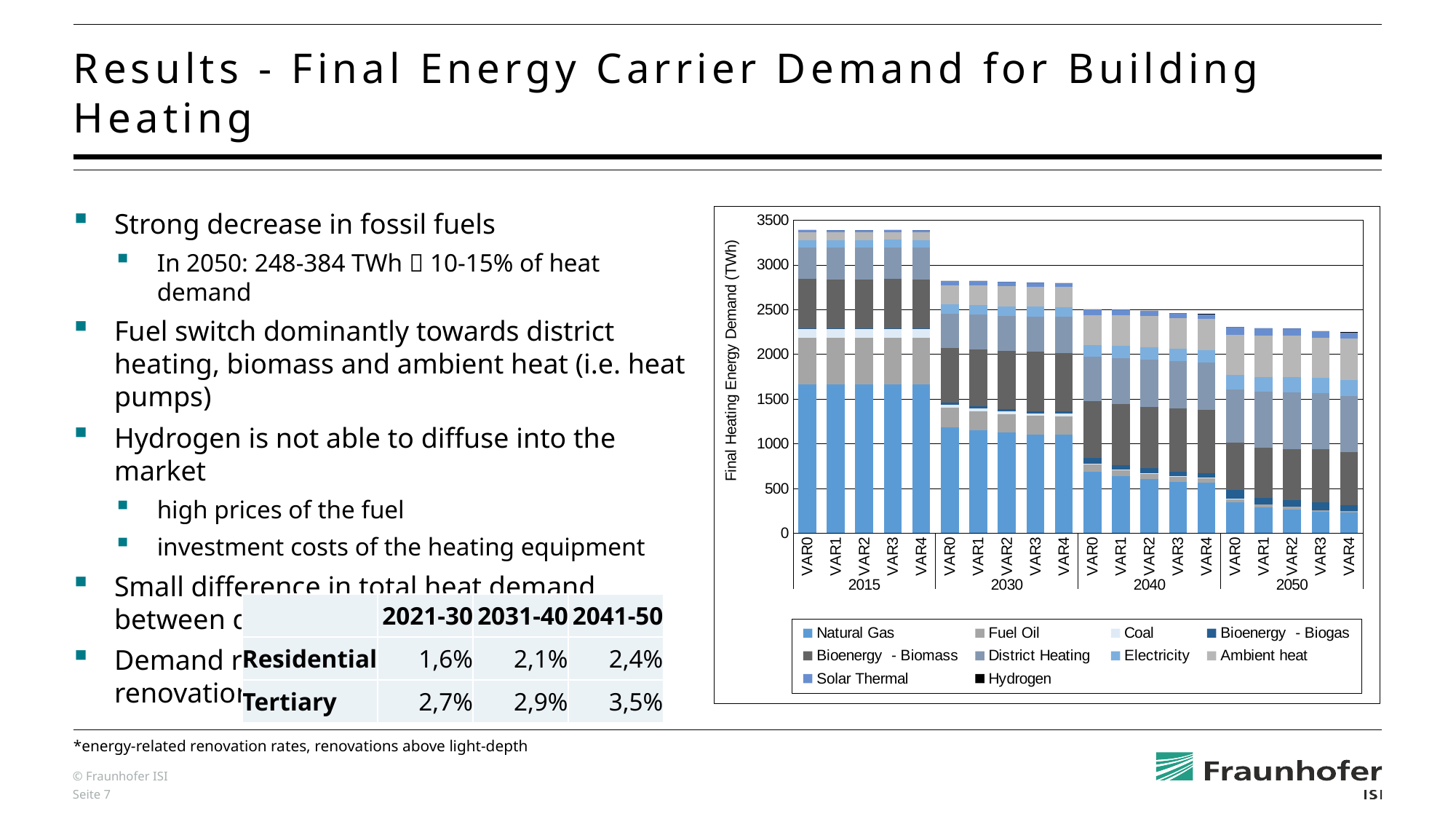
Is the Natural Gas value for VAR0 in 2015 greater or less than 1500? greater How many series does the chart legend list? 10 Which is larger, the total bar for VAR0 in 2015 or the total bar for VAR0 in 2050? VAR0 in 2015 What kind of chart is shown on the slide? Stacked bar chart What is the label of the y axis of the chart? Final Heating Energy Demand (TWh) Do the total bar heights rise or fall from 2015 to 2050 along the x axis? Fall Is the total height of the VAR0 bar for 2015 greater or less than 3000? greater Is the Natural Gas value for VAR4 in 2050 greater or less than 500? less How many year groups are shown on the x axis of the chart? 4 Which series in the legend is shown in black? Hydrogen How many bars are plotted in the chart? 20